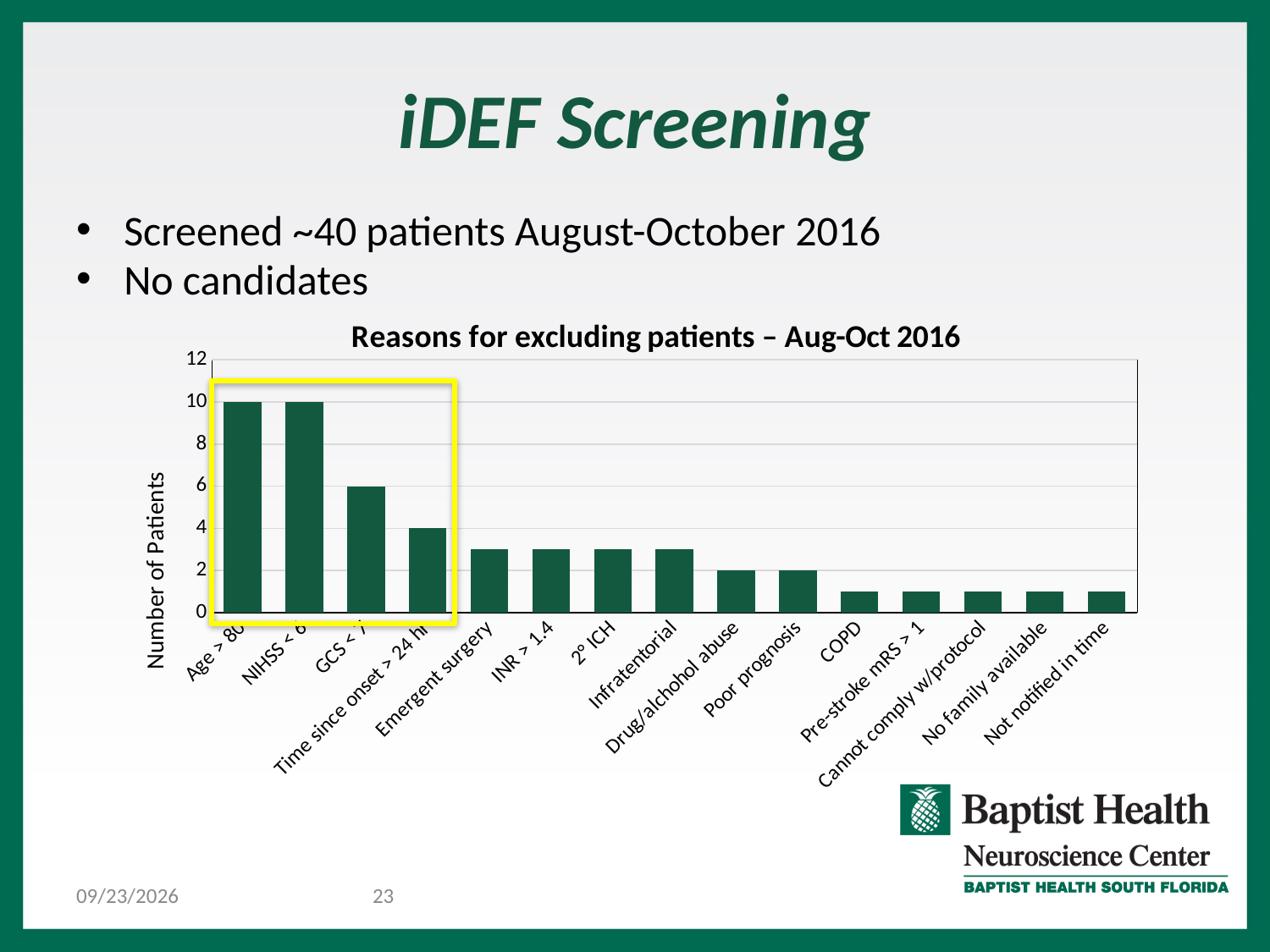
What is the difference between the number of patients excluded for Age > 80 and for GCS < 7? 4 What is the label on the vertical axis of the chart? Number of Patients How many exclusion reasons (categories) are shown on the x axis? 15 How many patients were excluded for Age > 80? 10 What is the title of the chart? Reasons for excluding patients – Aug-Oct 2016 How many patients were excluded for NIHSS < 6? 10 How many patients were excluded for Time since onset > 24 hr? 4 How many patients were excluded for GCS < 7? 6 How many patients were excluded for Poor prognosis? 2 Which exclusion reason has more patients: GCS < 7 or Time since onset > 24 hr? GCS < 7 What type of chart is shown on the slide? Bar chart Is the value for Emergent surgery greater or less than 4? less